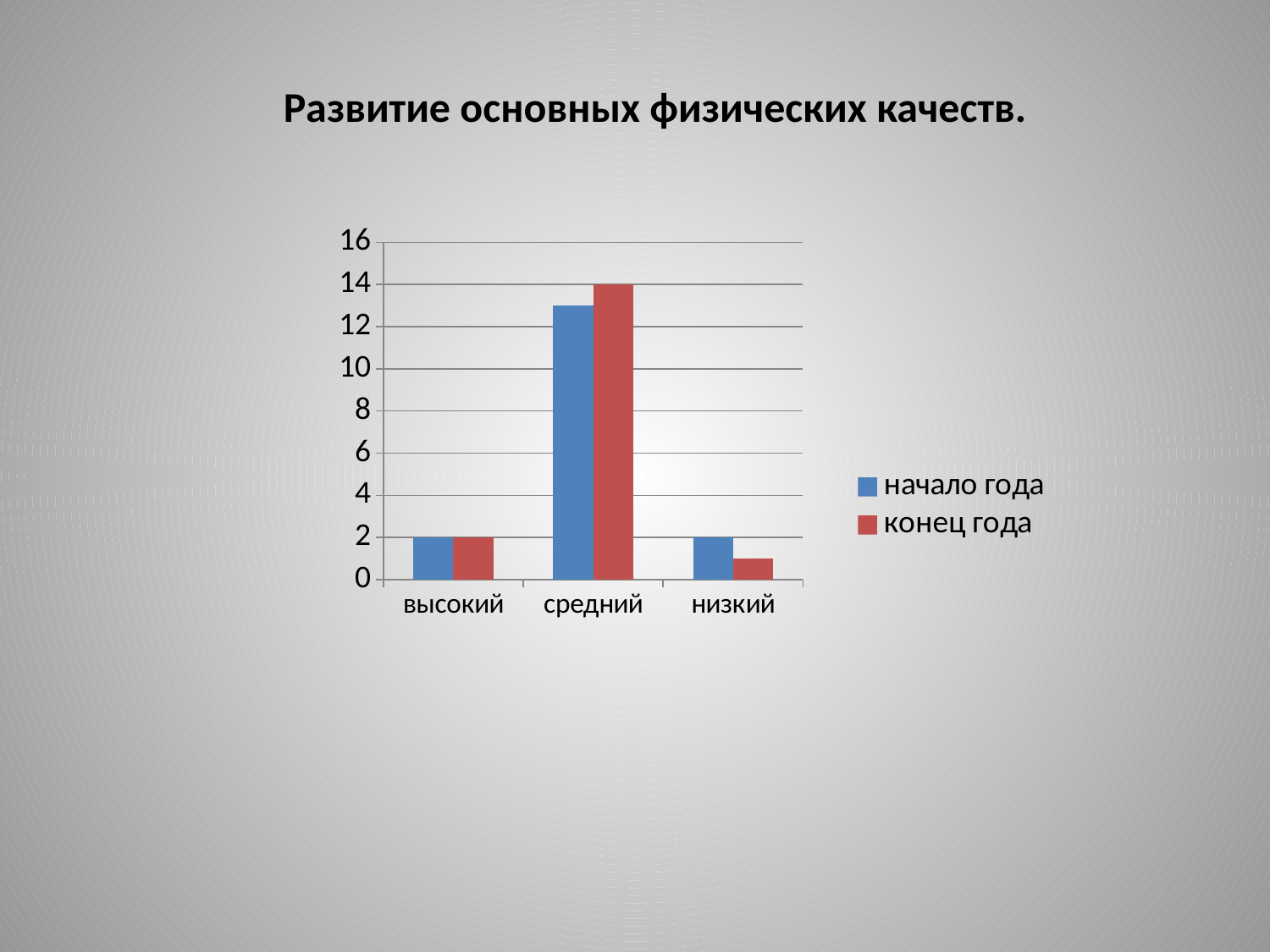
What is the value for низкий in the начало года series? 2 What is the value for средний in the конец года series? 14 Which category has the lowest value in the конец года series? низкий Is the value for низкий in the конец года series greater or less than 2? less How many categories are shown on the x axis? 3 What is the title of the slide? Развитие основных физических качеств. Is the value for средний in the начало года series greater or less than 12? greater For низкий, which series has the larger value, начало года or конец года? начало года What is the value for высокий in the начало года series? 2 How many series does the legend list? 2 What kind of chart is shown on the slide? bar chart Which category has the highest value in the конец года series? средний